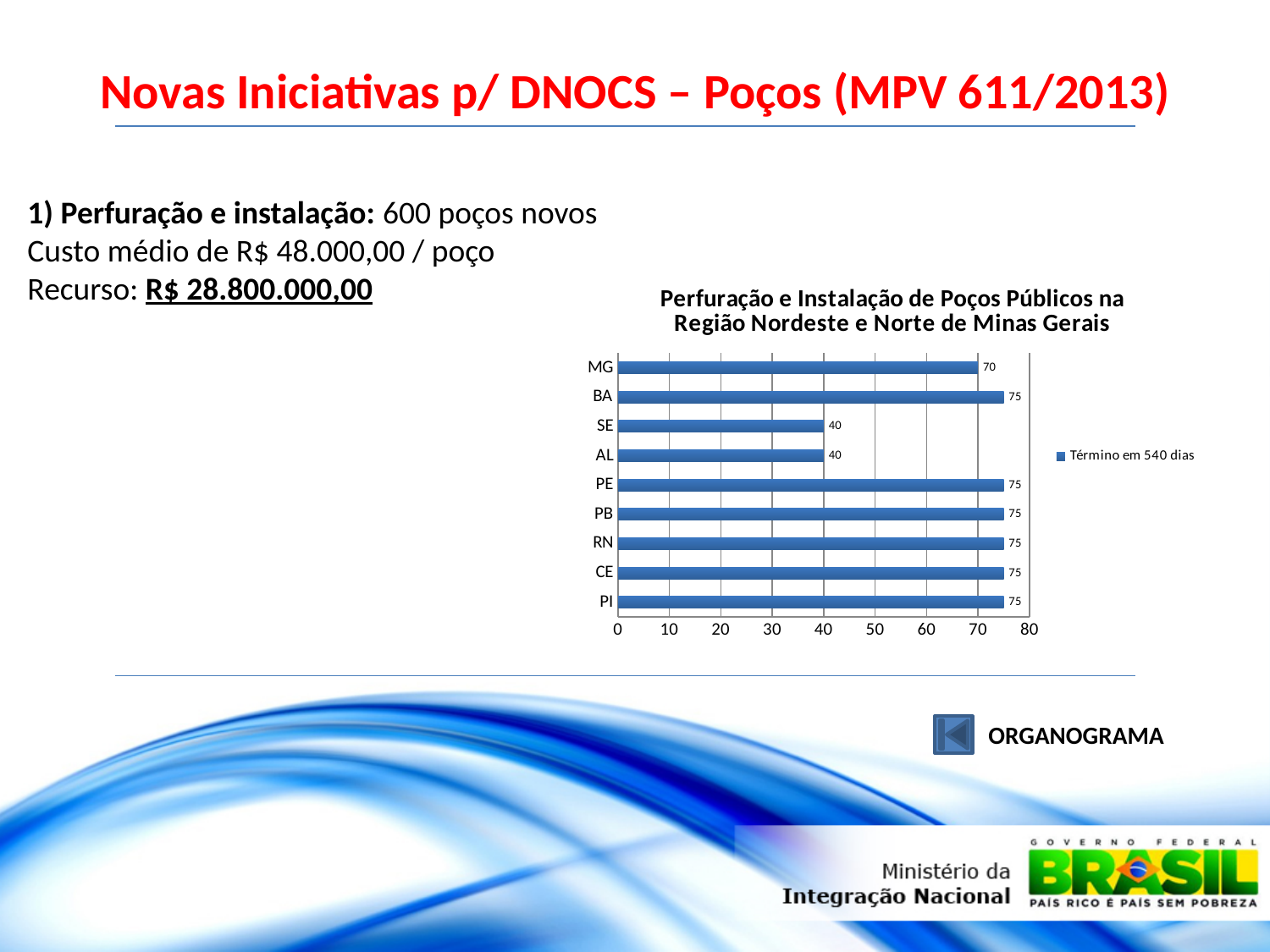
How many categories are shown on the chart? 9 Which categories have the lowest value? SE and AL What is the value for SE? 40 What is the difference between the values for PE and AL? 35 Is the value for MG greater or less than 60? greater What is the difference between the values for BA and MG? 5 What is the value for BA? 75 What kind of chart is shown? bar chart How many series does the legend list? 1 Which is larger, the value for MG or the value for SE? MG What is the value for MG? 70 What is the legend entry of the chart? Término em 540 dias